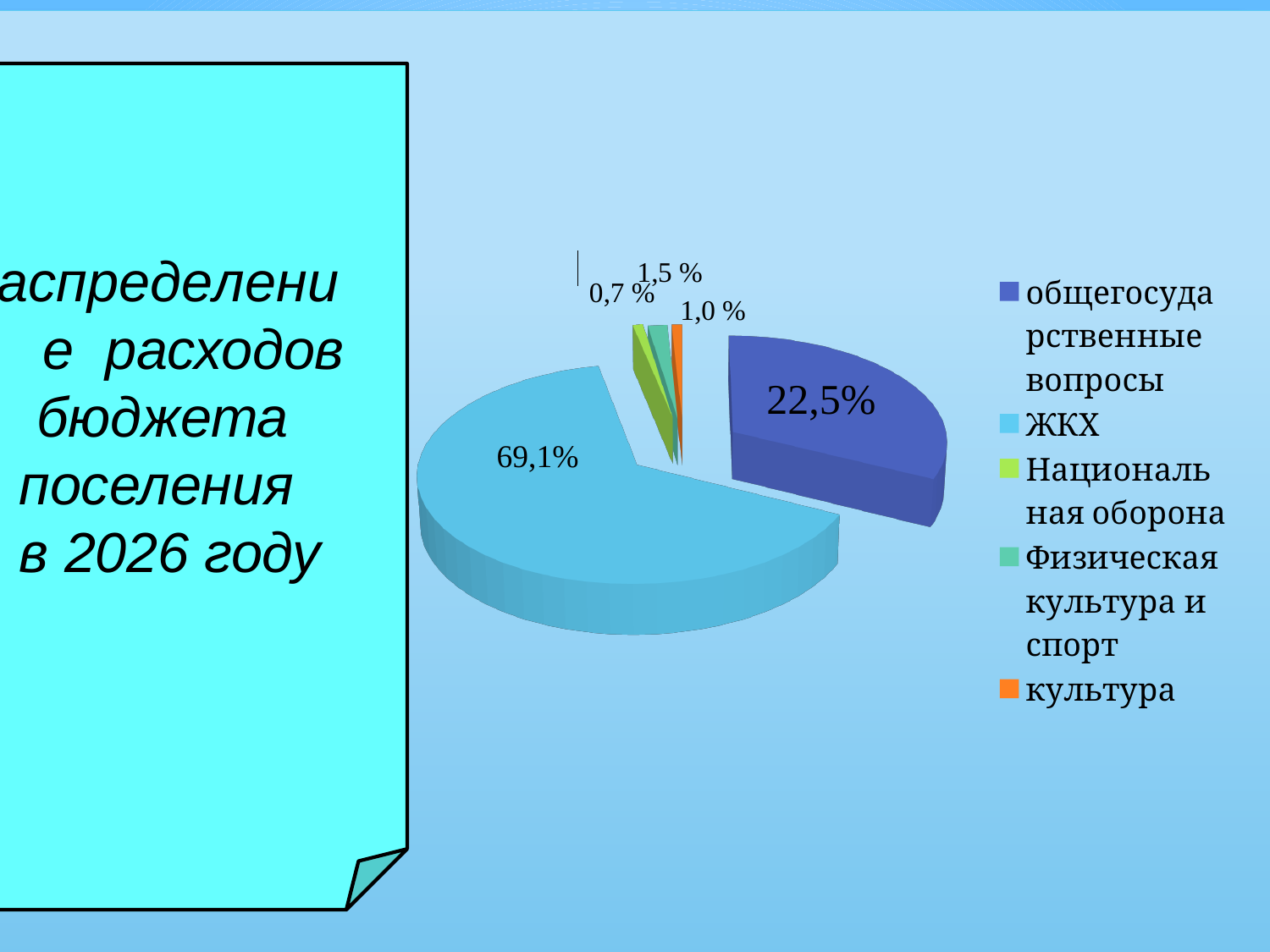
What is the difference in percentage points between the ЖКХ slice and the общегосударственные вопросы slice? 46,6 How many categories does the legend list? 5 What kind of chart is shown on the slide? pie chart What share of the pie does общегосударственные вопросы have? 22,5% Which category has the largest slice of the pie? ЖКХ What is the smallest percentage value printed on the chart? 0,7 % Is the share for ЖКХ greater or less than 50%? greater What share of the pie does ЖКХ have? 69,1% Which colour represents культура in the legend? orange Which year does the slide title say the budget expenditure distribution refers to? 2026 Which is larger, the slice for ЖКХ or the slice for общегосударственные вопросы? ЖКХ